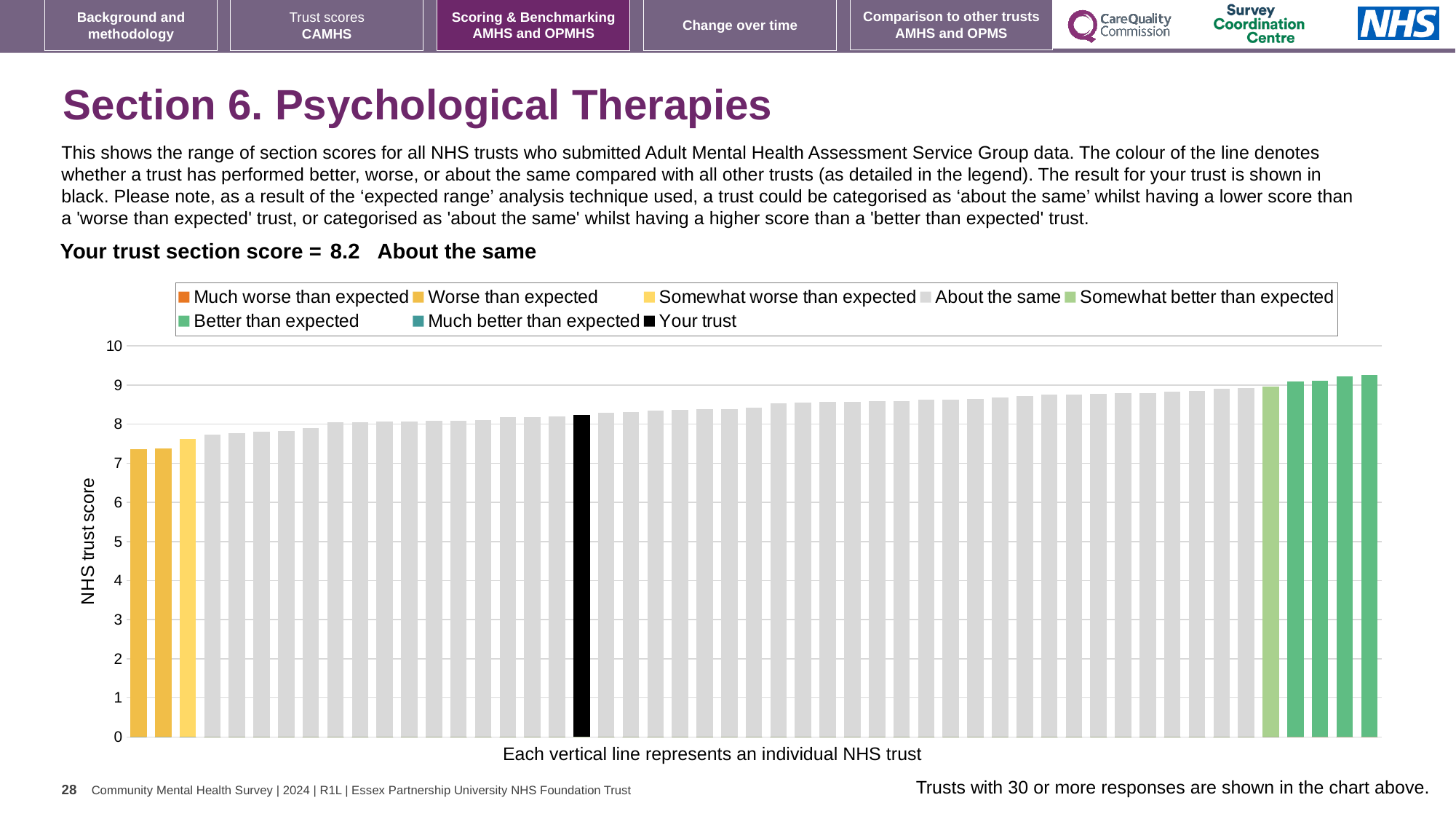
Is the value for your trust greater or less than 8? greater What kind of chart is shown on the slide? bar chart What colour is the bar representing your trust? black What is the title of the vertical axis? NHS trust score Which is larger: the value for your trust or the value of the leftmost bar? your trust How many entries does the chart legend list? 8 How is your trust's section score categorised compared with other trusts? About the same Do the bar values rise or fall from left to right across the chart? rise What is the section score for your trust shown on the slide? 8.2 Is the value of the leftmost bar greater or less than 8? less Is the value of the rightmost bar greater or less than 9? greater